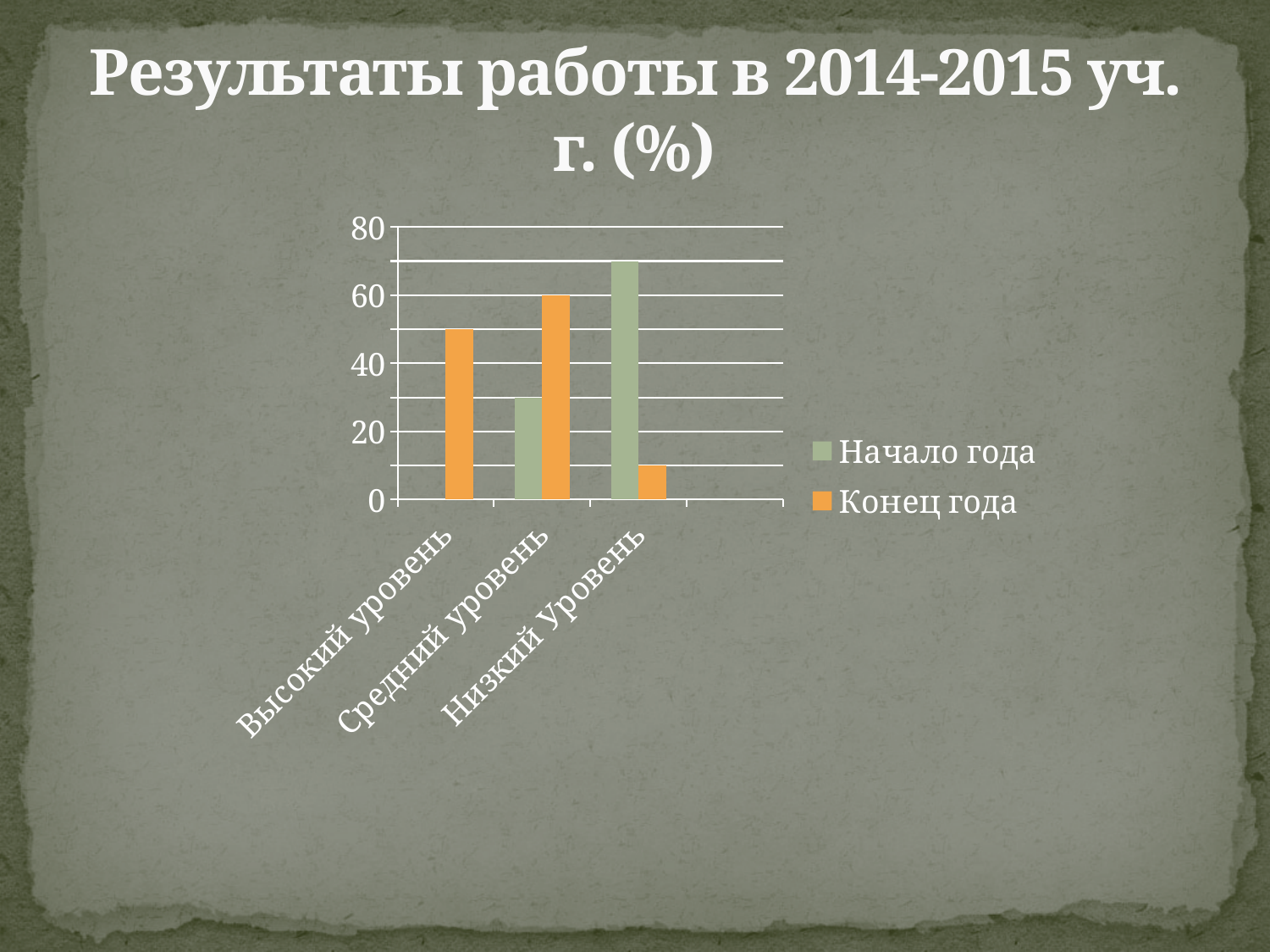
What kind of chart is shown on the slide? bar chart Is the value of Начало года for Средний уровень greater or less than 40? less Which category has the highest value for Начало года? Низкий уровень Is the value of Конец года for Высокий уровень greater or less than 40? greater What are the two series named in the legend? Начало года and Конец года For Низкий уровень, which is larger: Начало года or Конец года? Начало года Is the value of Конец года for Низкий уровень greater or less than 20? less For Средний уровень, which is larger: Начало года or Конец года? Конец года How many series does the legend list? 2 How many categories are shown on the x axis? 3 What is the value of Конец года for Средний уровень? 60